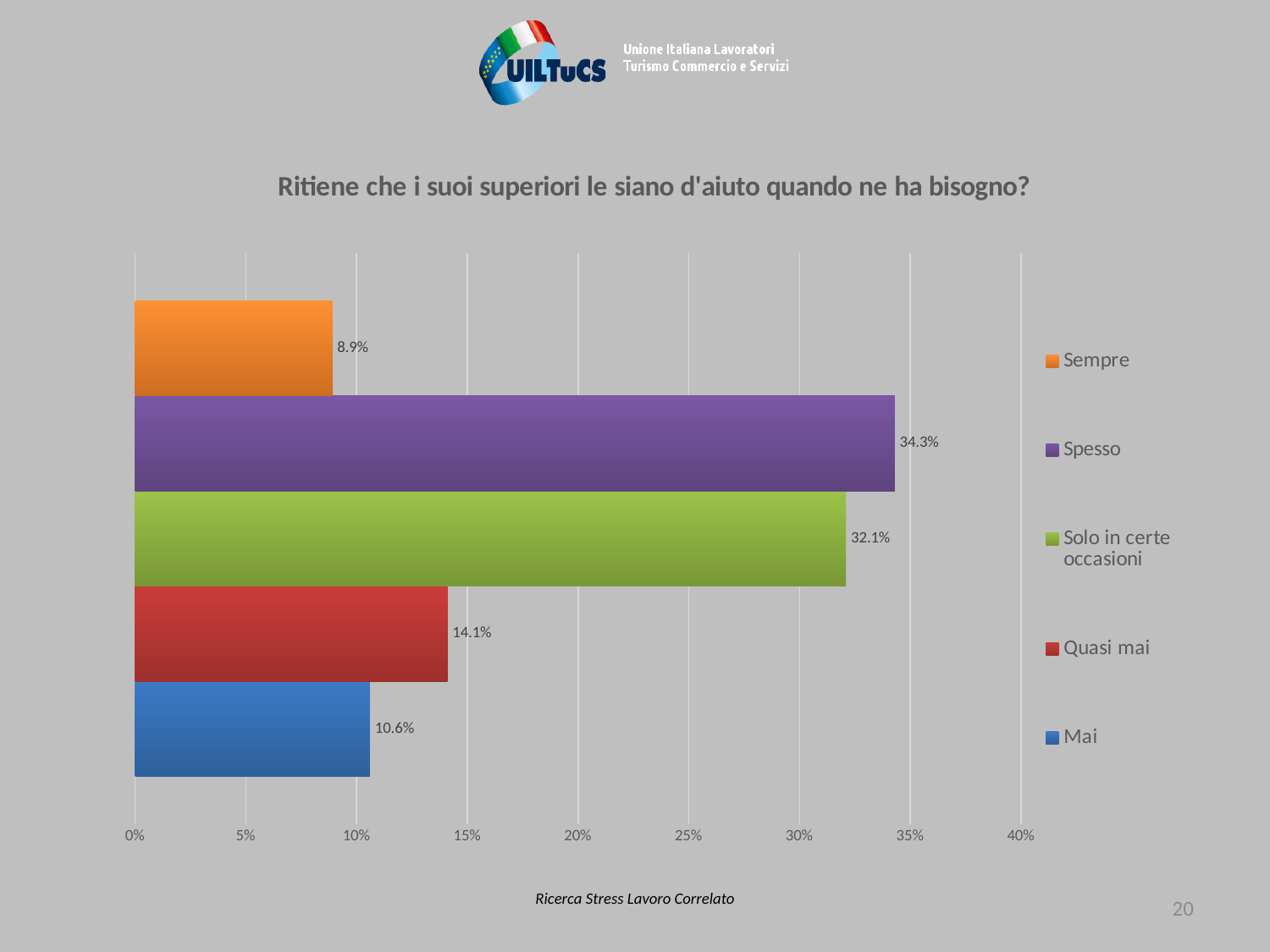
What is the difference between the values for Spesso and Solo in certe occasioni? 2.2% What is the value for Solo in certe occasioni? 32.1% Which category has the highest value? Spesso How many categories are shown in the chart? 5 What is the value for Sempre? 8.9% Which category has the lowest value? Sempre What kind of chart is shown on the slide? Bar chart What is the value for Quasi mai? 14.1% Which is larger, the value for Quasi mai or the value for Mai? Quasi mai What is the value for Spesso? 34.3% What is the title of the chart? Ritiene che i suoi superiori le siano d'aiuto quando ne ha bisogno? What is the value for Mai? 10.6%